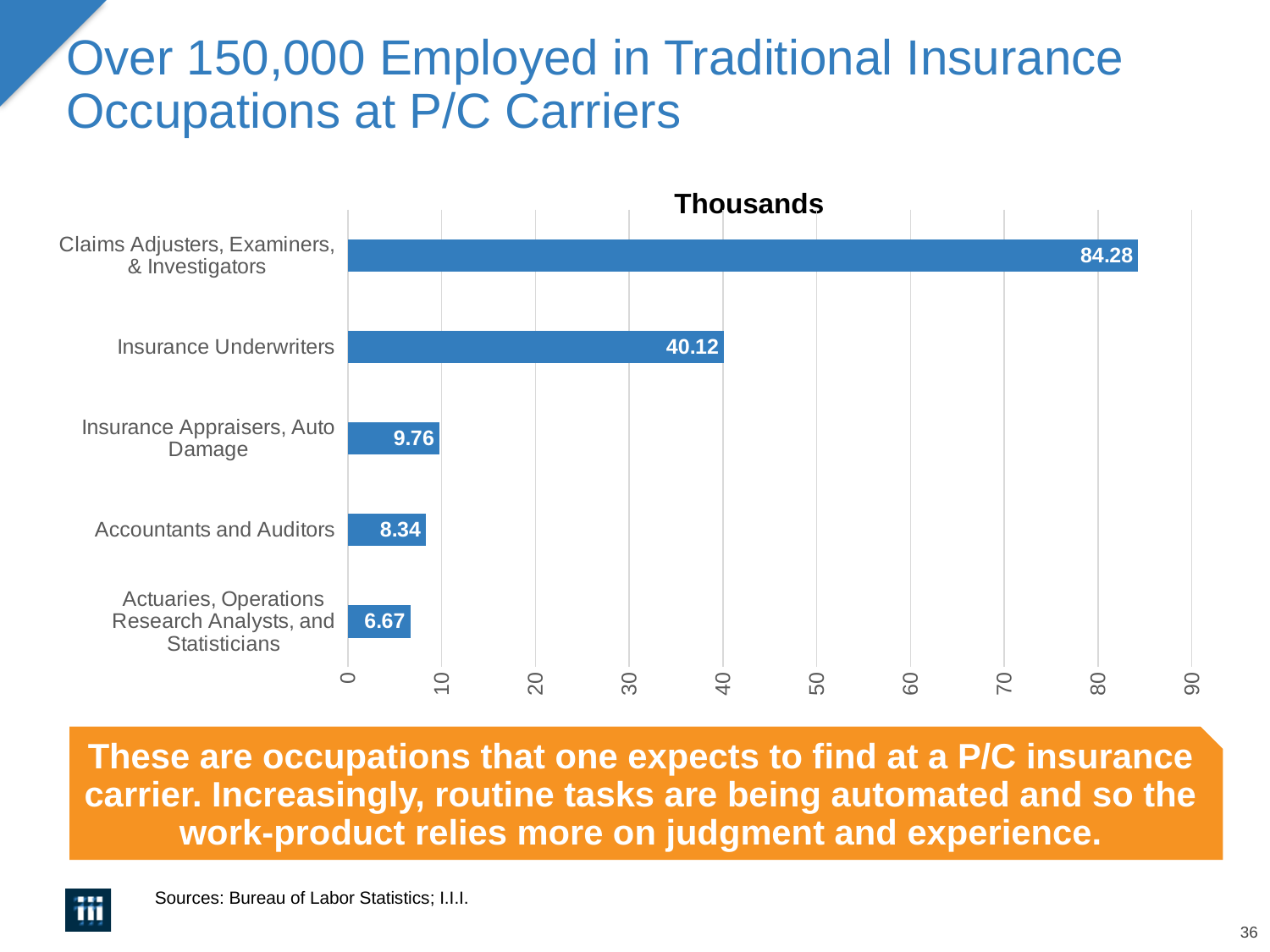
What is the title shown above the chart? Thousands What is the value for Insurance Underwriters? 40.12 What is the value for Accountants and Auditors? 8.34 What kind of chart is shown on the slide? bar chart Which occupation has the lowest value? Actuaries, Operations Research Analysts, and Statisticians What is the difference between the values for Claims Adjusters, Examiners, & Investigators and Insurance Underwriters? 44.16 How many occupations are shown in the chart? 5 Which occupation has the highest value? Claims Adjusters, Examiners, & Investigators What is the value for Actuaries, Operations Research Analysts, and Statisticians? 6.67 What is the value for Claims Adjusters, Examiners, & Investigators? 84.28 Is the value for Insurance Underwriters greater or less than 50? less Which is larger, the value for Insurance Appraisers, Auto Damage or the value for Accountants and Auditors? Insurance Appraisers, Auto Damage